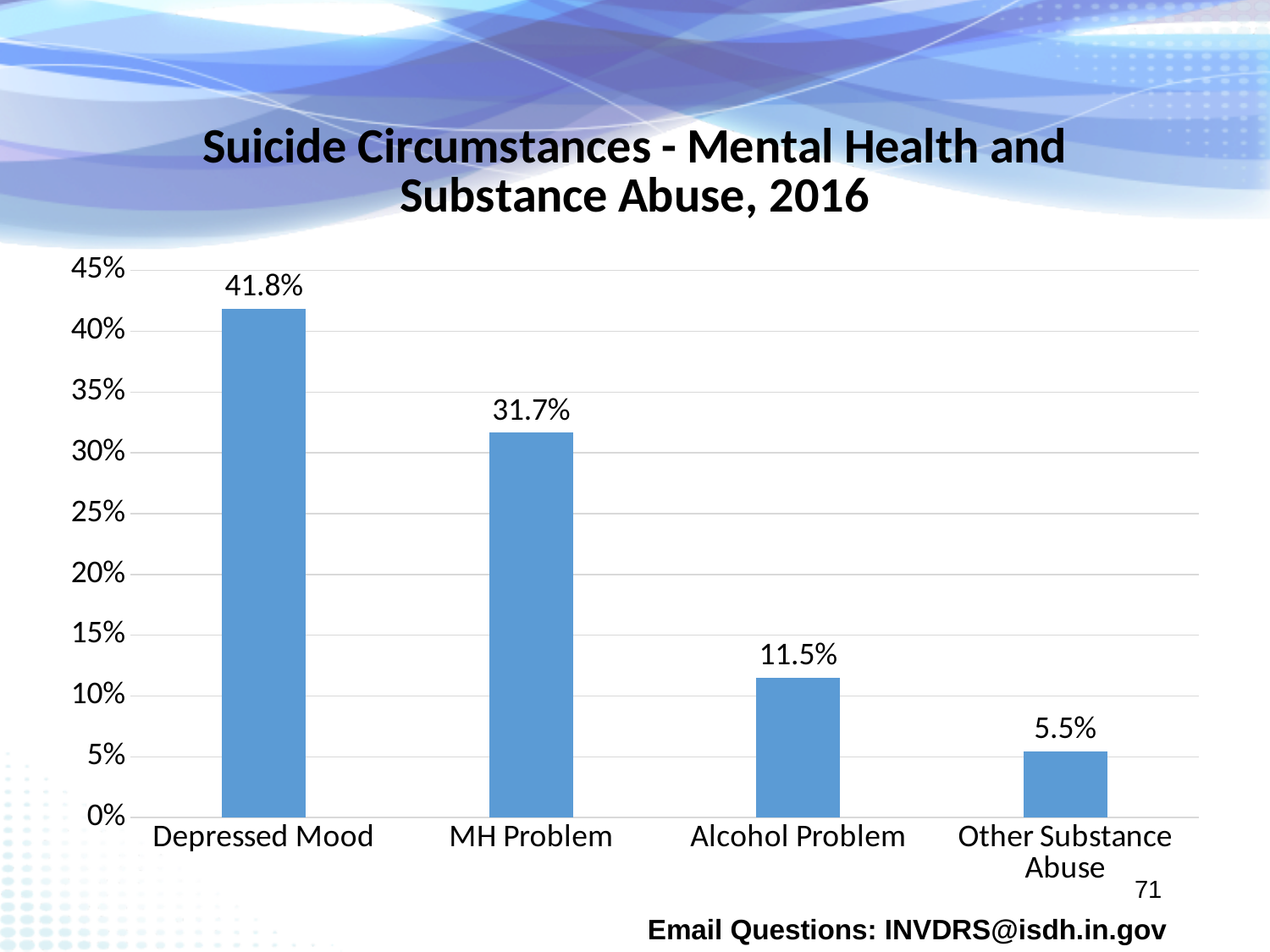
What is the value for Other Substance Abuse? 5.5% What is the value for Alcohol Problem? 11.5% What is the title of the chart? Suicide Circumstances - Mental Health and Substance Abuse, 2016 What is the value for Depressed Mood? 41.8% Which is larger, the value for MH Problem or the value for Alcohol Problem? MH Problem Which category has the highest value? Depressed Mood How many categories are shown on the chart? 4 What is the difference between the values for Depressed Mood and MH Problem? 10.1% What is the difference between the values for Alcohol Problem and Other Substance Abuse? 6.0% Which category has the lowest value? Other Substance Abuse What kind of chart is shown on the slide? Bar chart What is the value for MH Problem? 31.7%